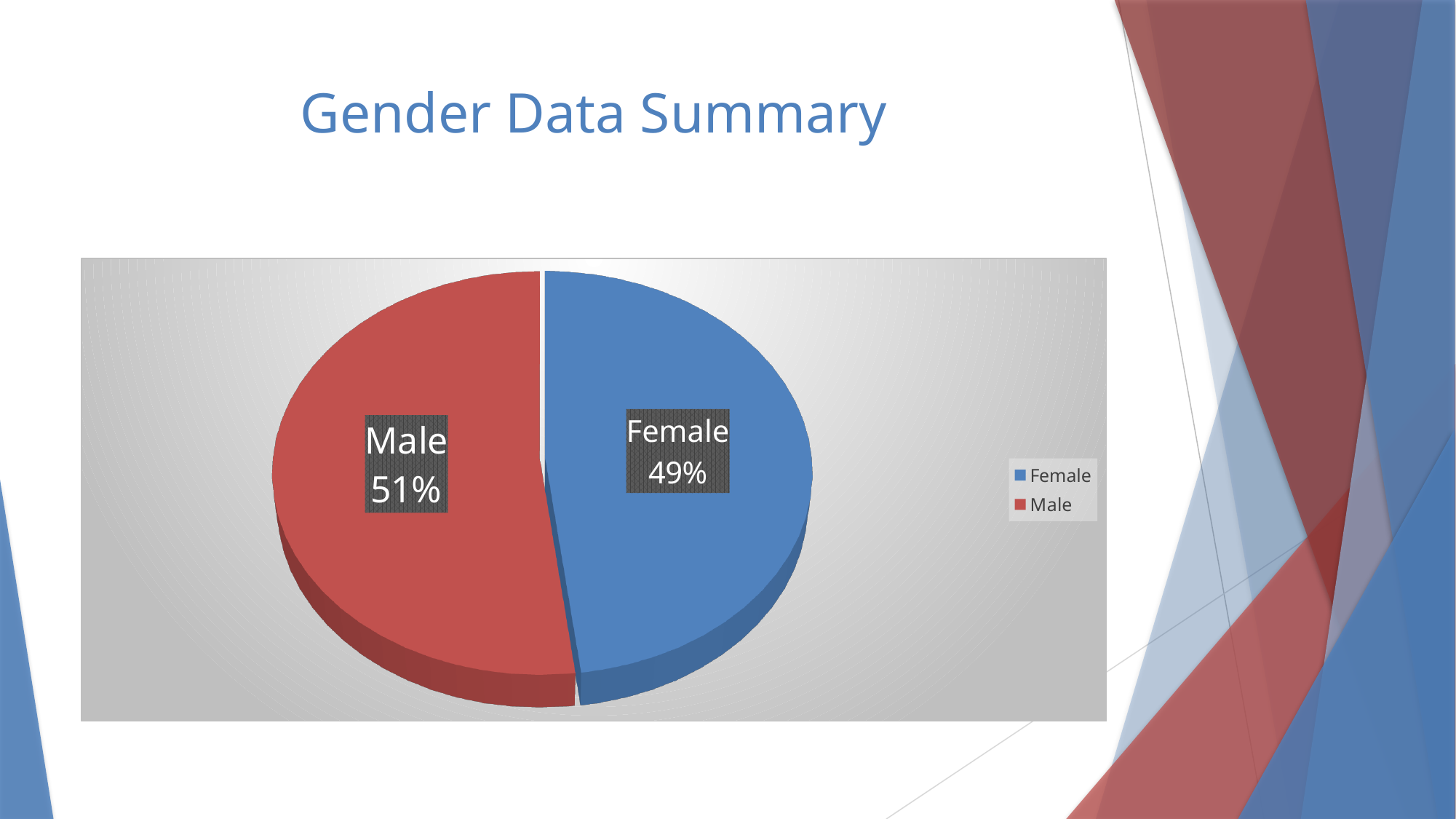
Which slice is the largest in the pie chart? Male How many entries does the legend list? 2 What kind of chart is shown on the slide? pie chart What share of the pie does the Female slice represent? 49% What is the title of the slide containing the chart? Gender Data Summary Which slice is the smallest in the pie chart? Female What share of the pie does the Male slice represent? 51% Which is larger, the Male slice or the Female slice? Male What colour is the Female slice in the pie chart? blue How many slices does the pie chart have? 2 What is the difference in percentage points between the Male and Female slices? 2%